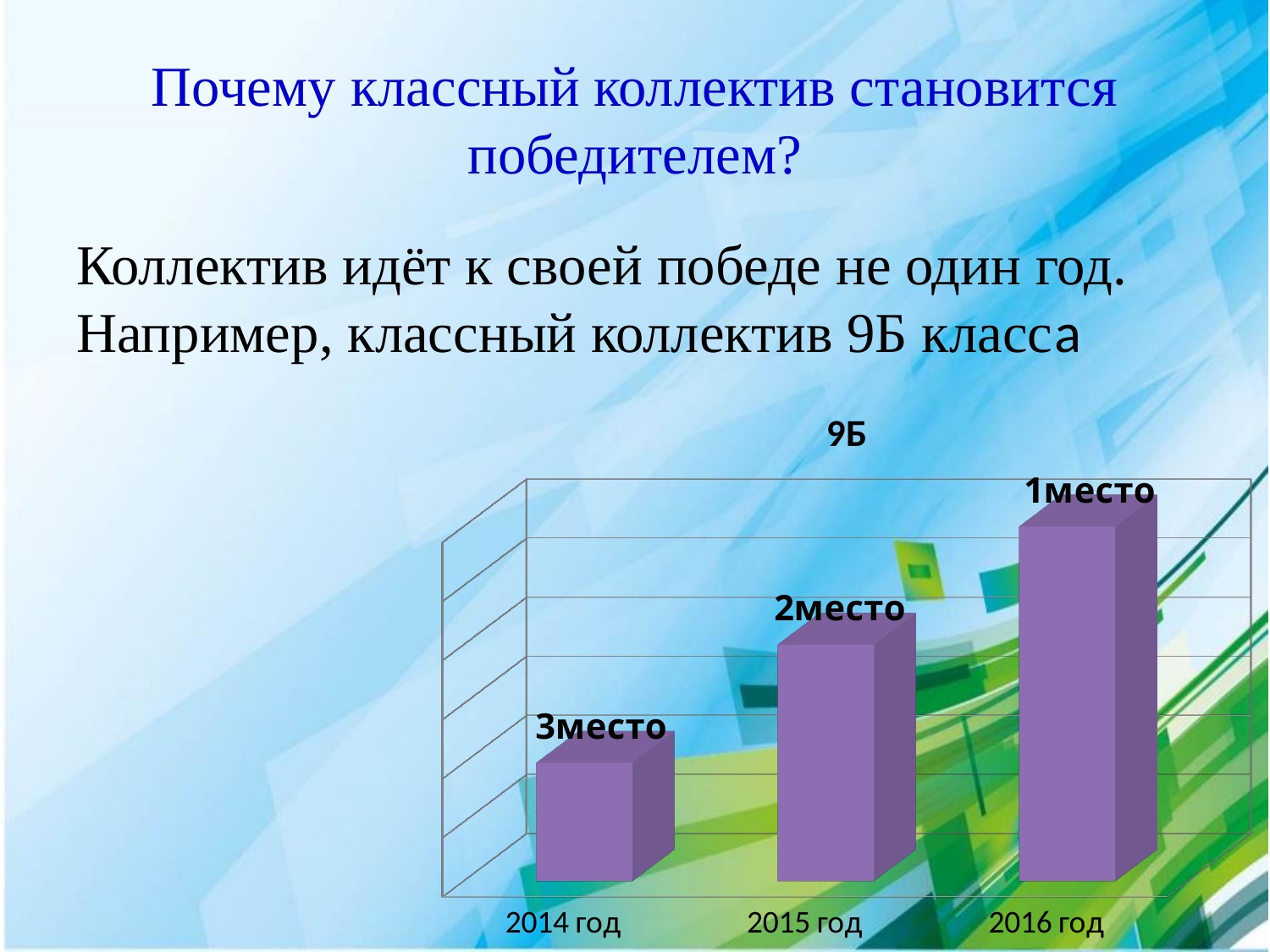
Which year's bar is labelled 1место? 2016 год Which bar is taller, 2015 год or 2014 год? 2015 год What is the data label on the bar for 2015 год? 2место How many categories are shown on the x axis of the chart? 3 What colour are the bars in the chart? purple Which year has the shortest bar in the chart? 2014 год What is the title of the chart? 9Б What kind of chart is shown on the slide? bar chart Do the bars rise or fall from 2014 год to 2016 год? rise What is the data label on the bar for 2014 год? 3место What is the data label on the bar for 2016 год? 1место Which year has the tallest bar in the chart? 2016 год